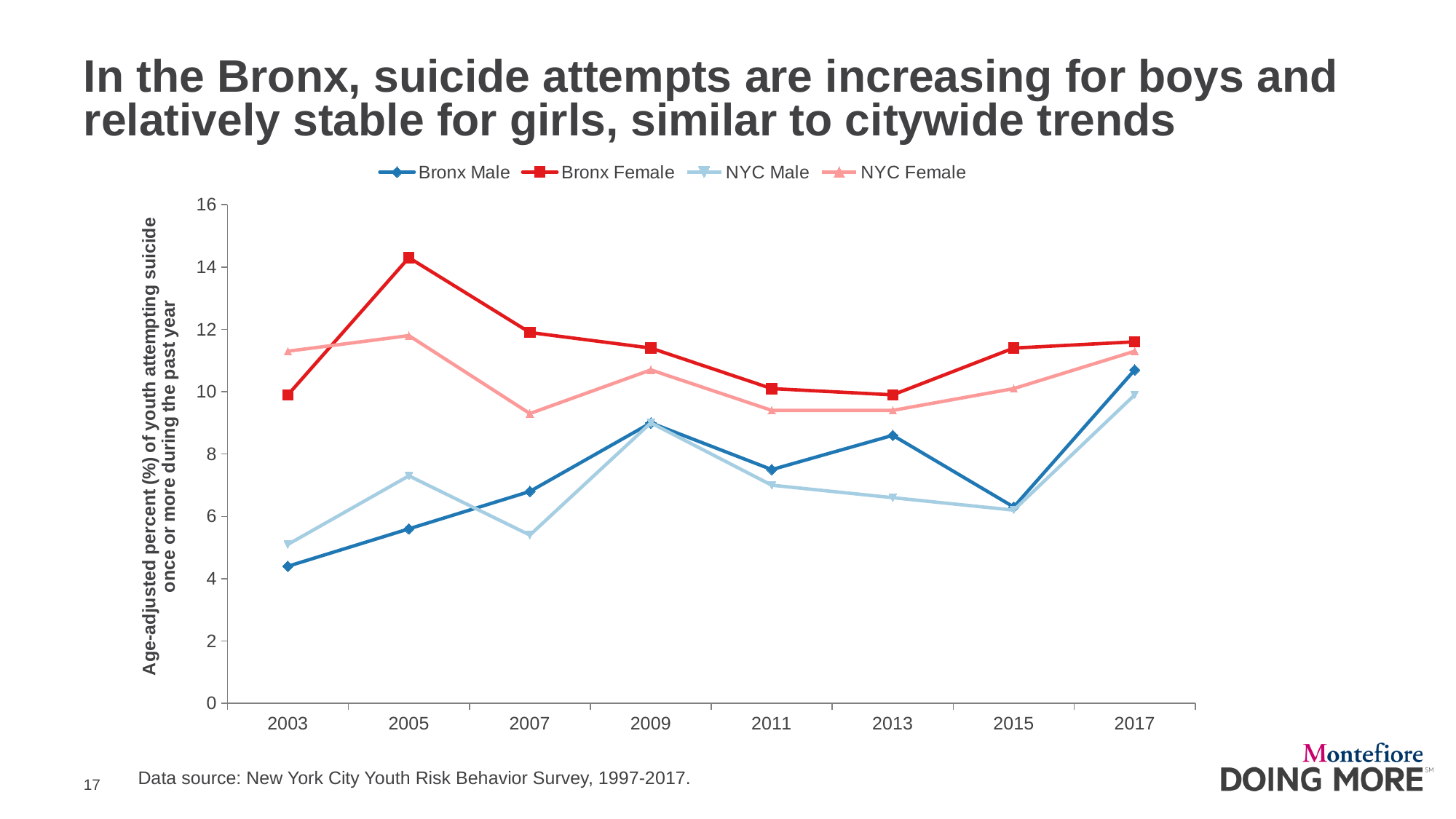
Is the value for Bronx Female in 2005 greater or less than 12? greater Does the Bronx Female series rise or fall between 2005 and 2013? Fall How many years are plotted along the x axis? 8 In which year does the Bronx Female series reach its highest value? 2005 What kind of chart is shown on the slide? Line chart What is the label on the y axis? Age-adjusted percent (%) of youth attempting suicide once or more during the past year In which year is the Bronx Male series at its lowest value? 2003 In 2007, which series has the higher value: Bronx Male or NYC Male? Bronx Male In 2003, which series has the higher value: Bronx Female or NYC Female? NYC Female Is the value for NYC Female in 2007 greater or less than 10? less Is the value for Bronx Male in 2003 greater or less than 6? less How many series does the legend list? 4